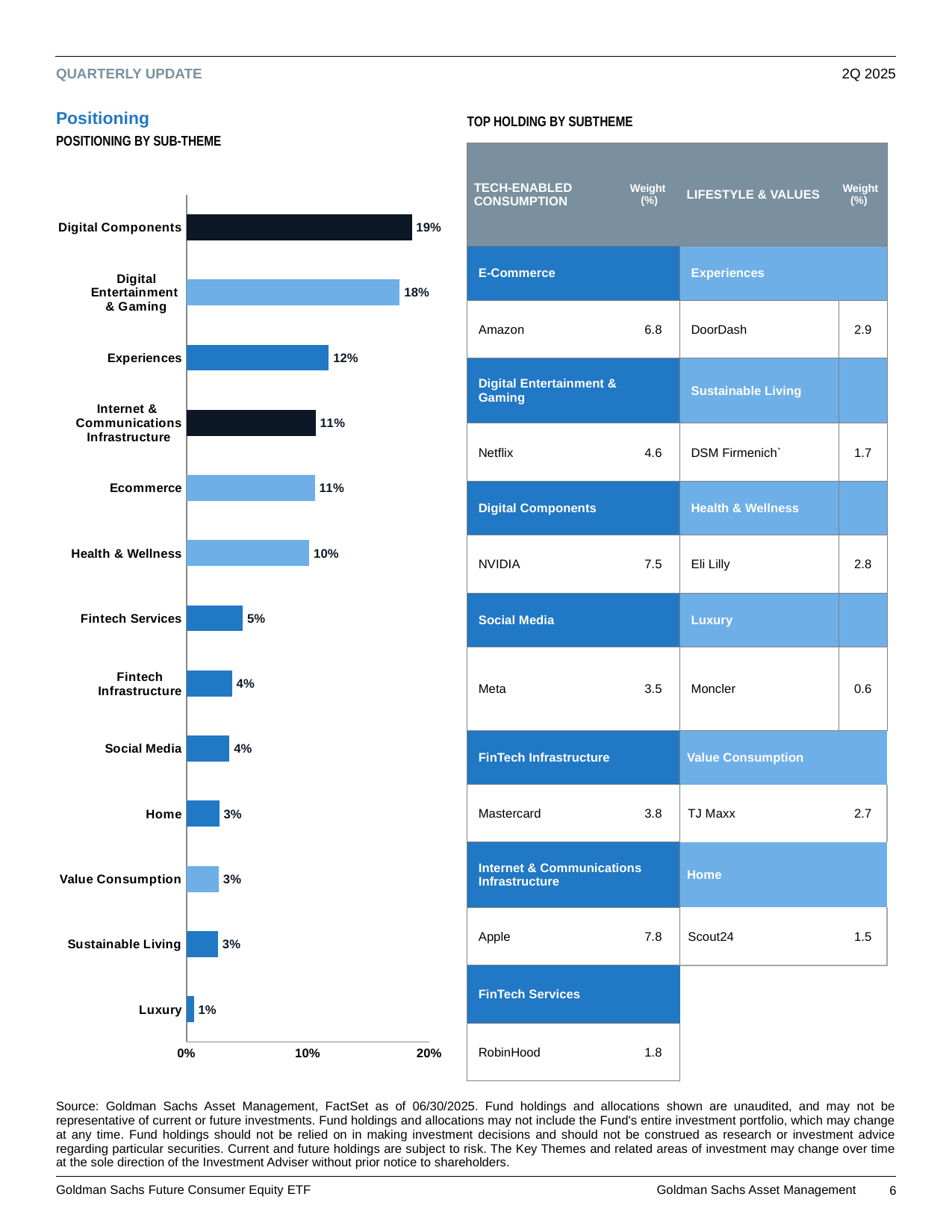
Which sub-theme has the lowest value in the Positioning by Sub-Theme chart? Luxury What is the value for Health & Wellness in the Positioning by Sub-Theme chart? 10% What is the value for Digital Components in the Positioning by Sub-Theme chart? 19% Which is larger in the Positioning by Sub-Theme chart, Experiences or Health & Wellness? Experiences Which sub-theme has the highest value in the Positioning by Sub-Theme chart? Digital Components What is the difference between Digital Components and Digital Entertainment & Gaming in the Positioning by Sub-Theme chart? 1% What kind of chart is the Positioning by Sub-Theme chart? Bar chart Is the value for Digital Entertainment & Gaming in the Positioning by Sub-Theme chart greater or less than 10%? greater How many sub-themes are shown in the Positioning by Sub-Theme chart? 13 What is the difference between Experiences and Fintech Services in the Positioning by Sub-Theme chart? 7% What is the value for Fintech Services in the Positioning by Sub-Theme chart? 5% What is the maximum value shown on the x axis of the Positioning by Sub-Theme chart? 20%